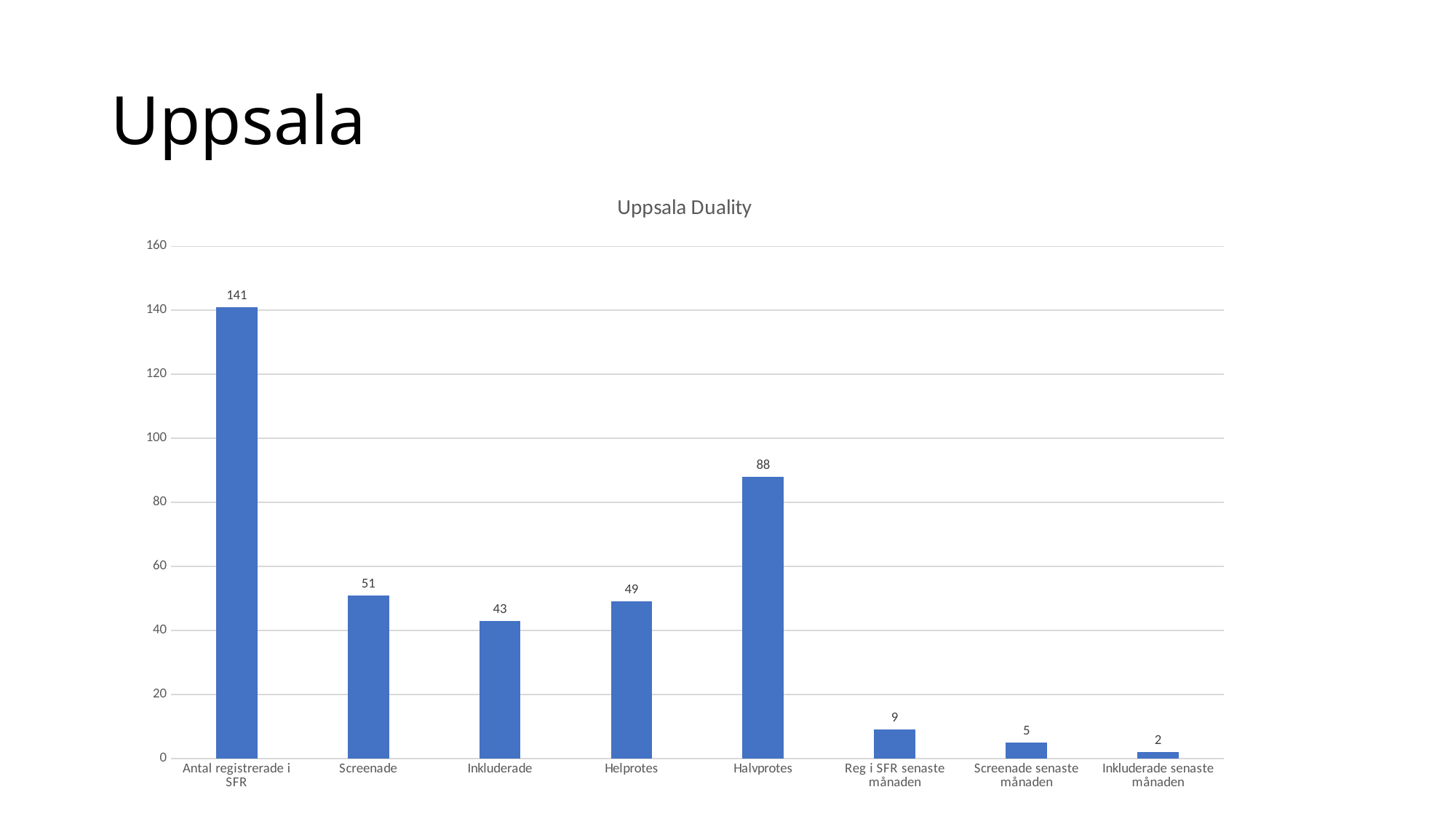
How many categories are shown on the chart? 8 What is the difference between Screenade and Inkluderade? 8 What kind of chart is shown on the slide? Bar chart What is the title of the chart? Uppsala Duality Which is larger, Screenade or Helprotes? Screenade What is the value for Halvprotes? 88 Is the value for Halvprotes greater or less than 80? greater Which category has the lowest value? Inkluderade senaste månaden What is the difference between Halvprotes and Helprotes? 39 What is the value for Antal registrerade i SFR? 141 Which category has the highest value? Antal registrerade i SFR What is the value for Inkluderade senaste månaden? 2